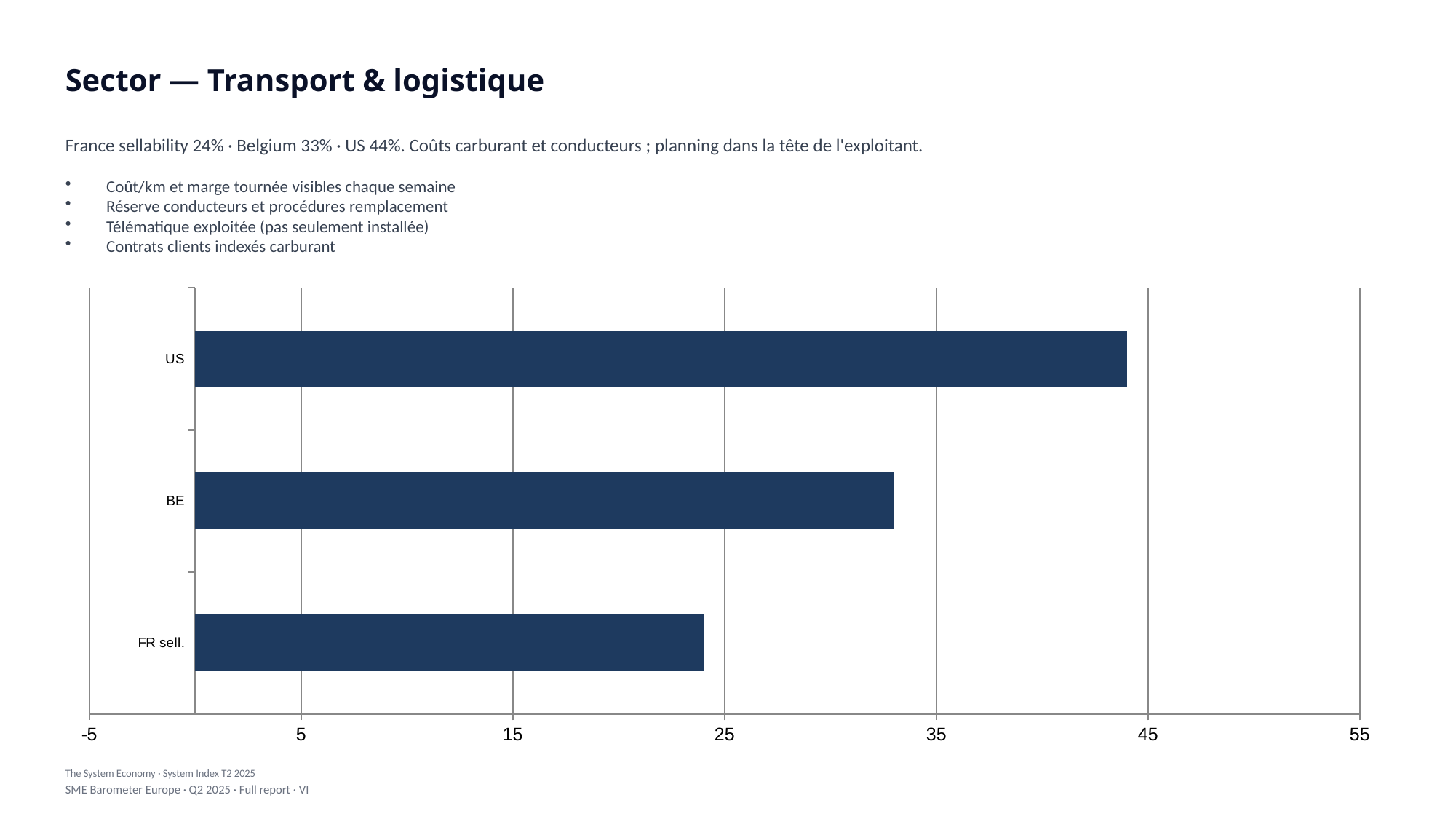
What kind of chart is shown on the slide? bar chart Which is larger in the bar chart, the value for US or the value for BE? US Which category has the highest value in the bar chart? US Is the value for FR sell. greater or less than 15? greater Which category has the lowest value in the bar chart? FR sell. Is the value for BE greater or less than 25? greater Is the value for US greater or less than 35? greater Which is larger in the bar chart, the value for BE or the value for FR sell.? BE How many categories does the bar chart show? 3 What is the label of the category shown at the bottom of the bar chart? FR sell.